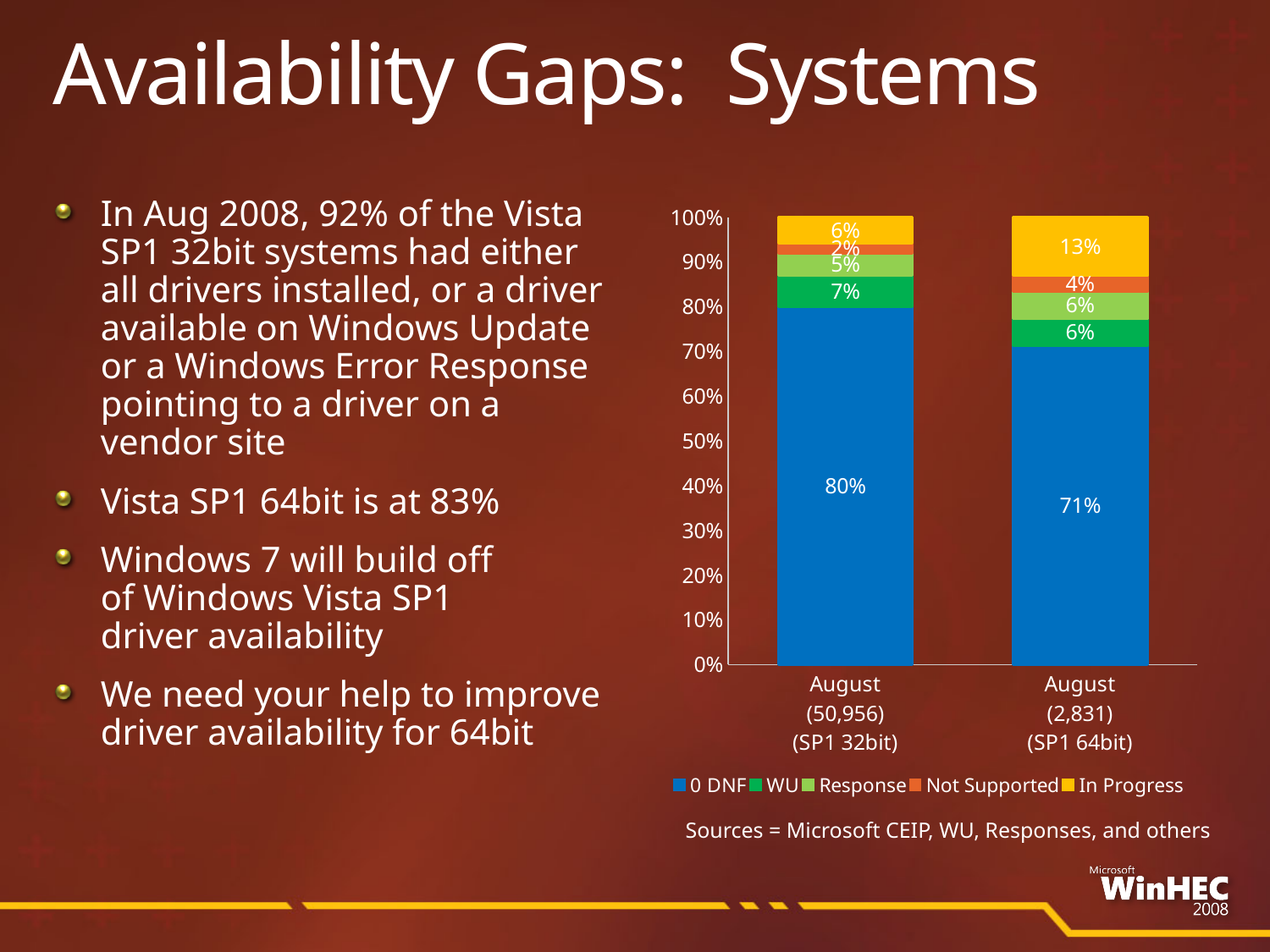
Which bar has the larger In Progress share, SP1 32bit or SP1 64bit? SP1 64bit Which series is the smallest segment in the SP1 32bit bar? Not Supported What is the 0 DNF value for the SP1 64bit bar? 71% What is the WU value for the SP1 32bit bar? 7% How many bars (categories) are plotted in the chart? 2 What is the In Progress value for the SP1 64bit bar? 13% What is the difference between the 0 DNF values for SP1 32bit and SP1 64bit? 9% What is the 0 DNF value for the SP1 32bit bar? 80% What kind of chart is shown on the slide? stacked bar chart How many series does the chart legend list? 5 What is the Not Supported value for the SP1 32bit bar? 2% Which series is the largest segment in the SP1 64bit bar? 0 DNF